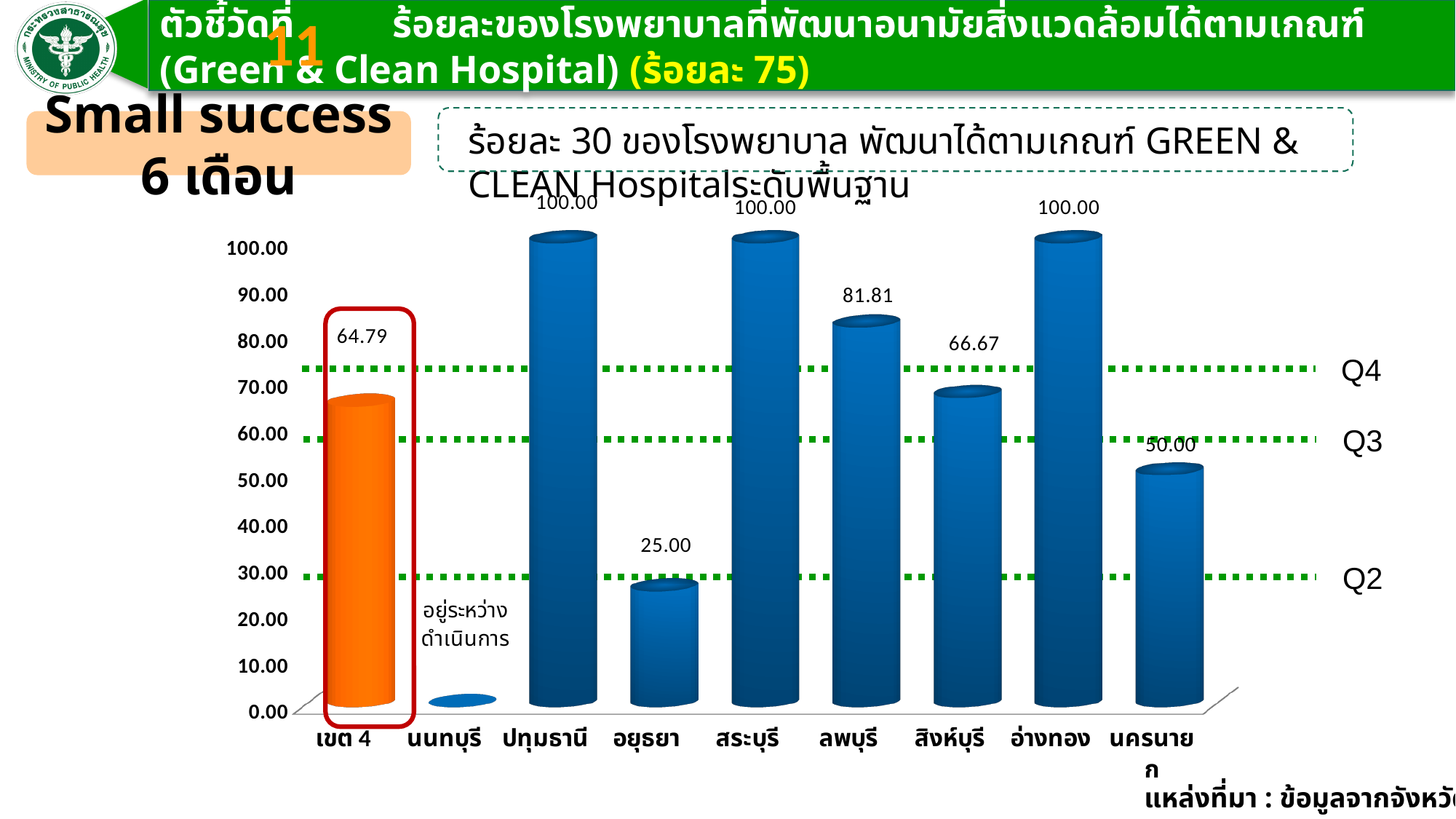
What is the difference between the values for ปทุมธานี and อยุธยา? 75.00 What is the value shown for สิงห์บุรี? 66.67 How many categories are shown on the x axis? 9 What is the value shown for เขต 4? 64.79 Among the provinces with a printed value, which has the lowest value? อยุธยา What is the value shown for ลพบุรี? 81.81 What is the difference between the values for ลพบุรี and สิงห์บุรี? 15.14 What is the value shown for นครนายก? 50.00 What kind of chart is shown on the slide? bar chart What colour is the bar for เขต 4? orange Which is larger, the value for เขต 4 or the value for นครนายก? เขต 4 What is the value shown for อยุธยา? 25.00